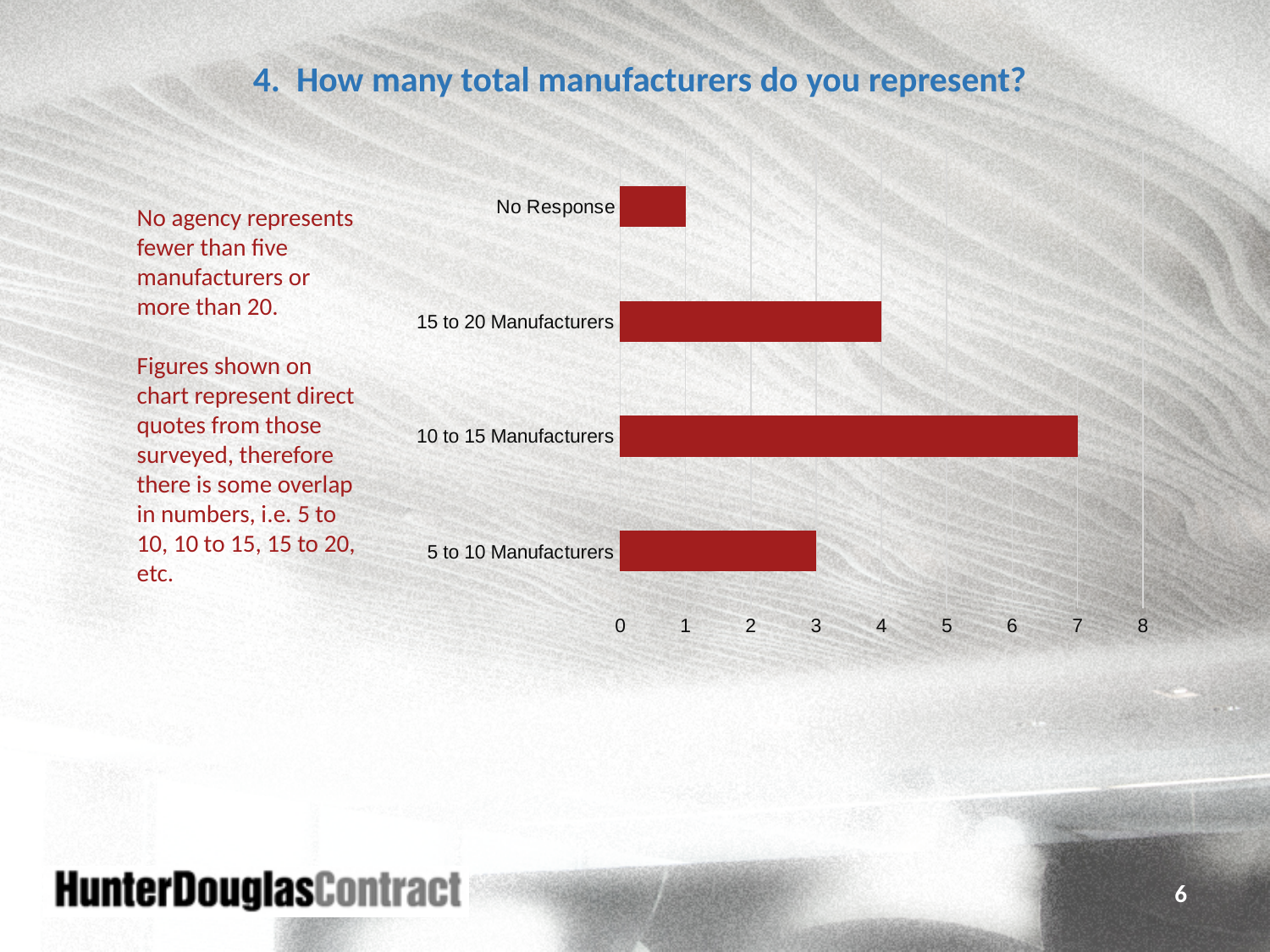
Which category has the lowest value? No Response Is the value for 10 to 15 Manufacturers greater or less than 5? greater How many categories does the chart show? 4 Which is larger, the value for 15 to 20 Manufacturers or the value for 5 to 10 Manufacturers? 15 to 20 Manufacturers What is the value for 5 to 10 Manufacturers? 3 What is the value for 10 to 15 Manufacturers? 7 What kind of chart is shown on the slide? bar chart What is the value for 15 to 20 Manufacturers? 4 What is the value for No Response? 1 What is the highest value shown on the horizontal axis? 8 What is the difference between the values for 10 to 15 Manufacturers and 15 to 20 Manufacturers? 3 Which category has the highest value? 10 to 15 Manufacturers